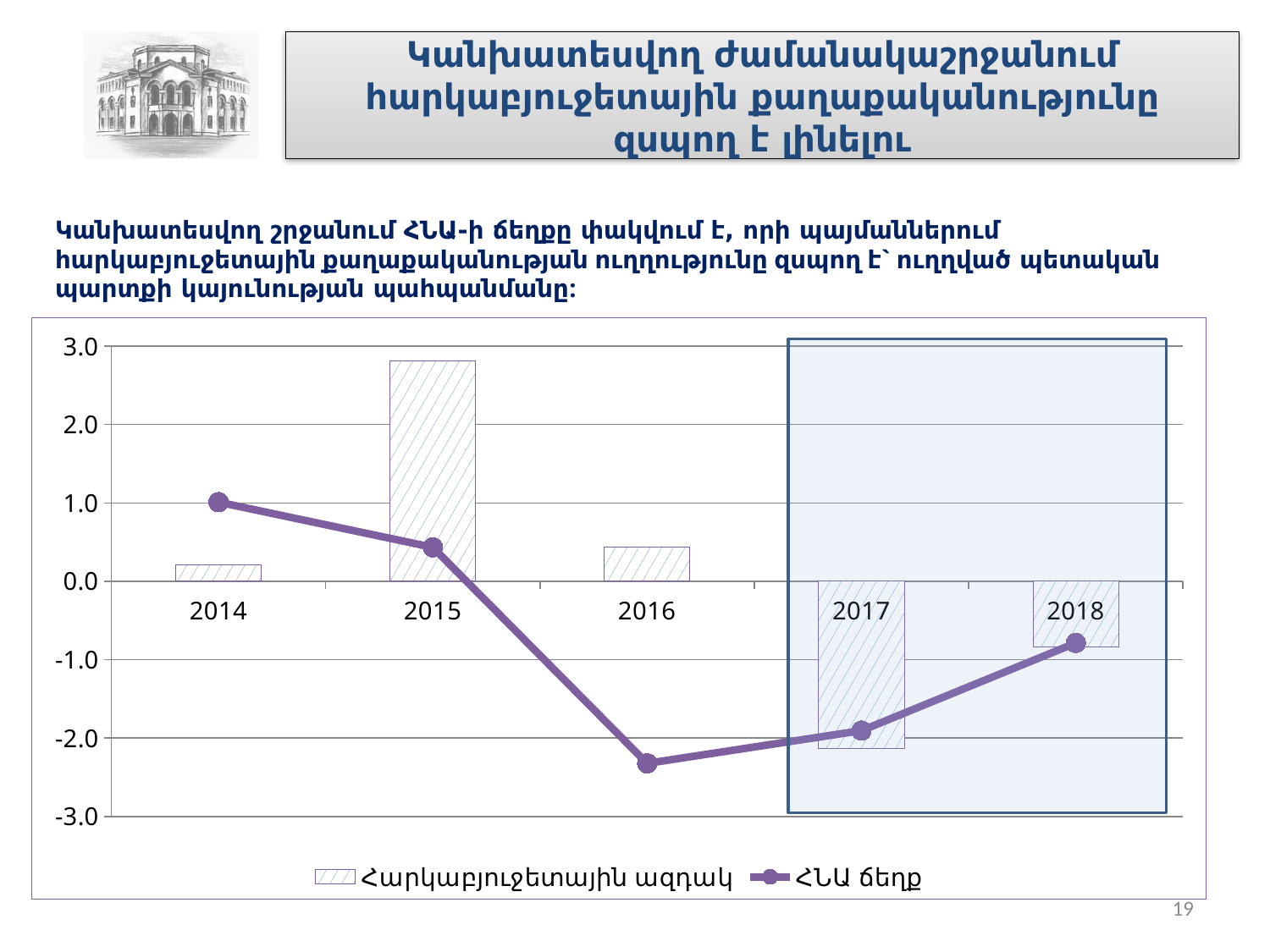
Is the Հարկաբյուջետային ազդակ bar for 2017 greater or less than -2.0? less Is the ՀՆԱ ճեղք value for 2016 greater or less than -2.0? less How many years are shown on the x axis of the chart? 5 Which two years on the chart are enclosed in the shaded highlight box? 2017 and 2018 Which year has the lowest bar for Հարկաբյուջետային ազդակ? 2017 Which year has the highest bar for Հարկաբյուջետային ազդակ? 2015 What kind of chart is shown on the slide? A combined bar and line chart How many series does the chart legend list? 2 In which year is the ՀՆԱ ճեղք line at its highest point? 2014 Is the Հարկաբյուջետային ազդակ bar for 2015 greater or less than 2.0? greater Which is larger, the Հարկաբյուջետային ազդակ bar for 2016 or for 2017? 2016 In which year is the ՀՆԱ ճեղք line at its lowest point? 2016